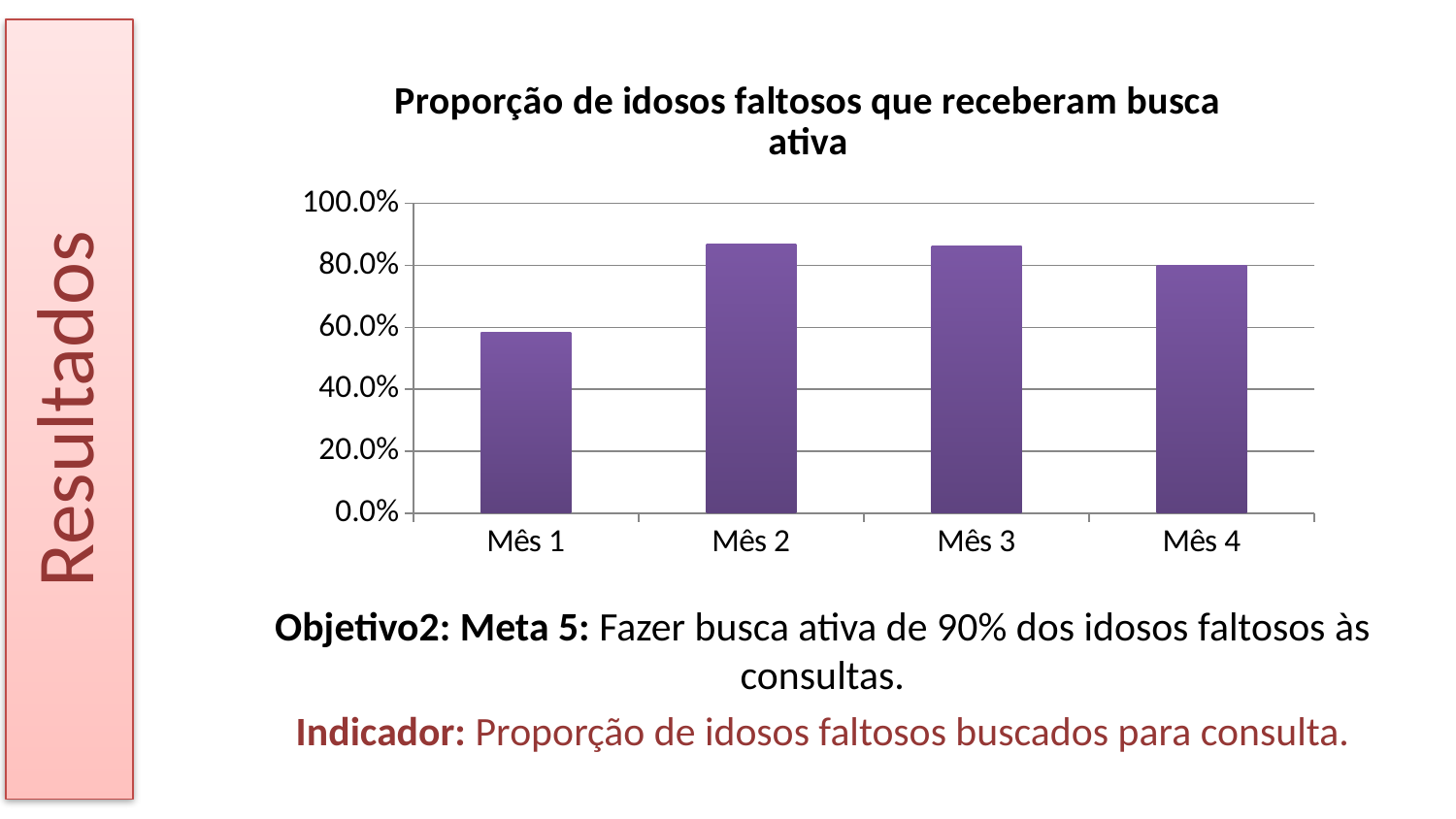
How many categories (months) are plotted on the x axis? 4 Which is larger, the value for Mês 1 or the value for Mês 2? Mês 2 Does the value rise or fall from Mês 1 to Mês 2? rise Which month has the lowest proportion of idosos faltosos que receberam busca ativa? Mês 1 Is the value for Mês 3 greater or less than 80.0%? greater Which is larger, the value for Mês 3 or the value for Mês 4? Mês 3 What is the title of the chart? Proporção de idosos faltosos que receberam busca ativa Is the value for Mês 1 greater or less than 40.0%? greater Is the value for Mês 1 greater or less than 60.0%? less What kind of chart is shown on the slide? bar chart